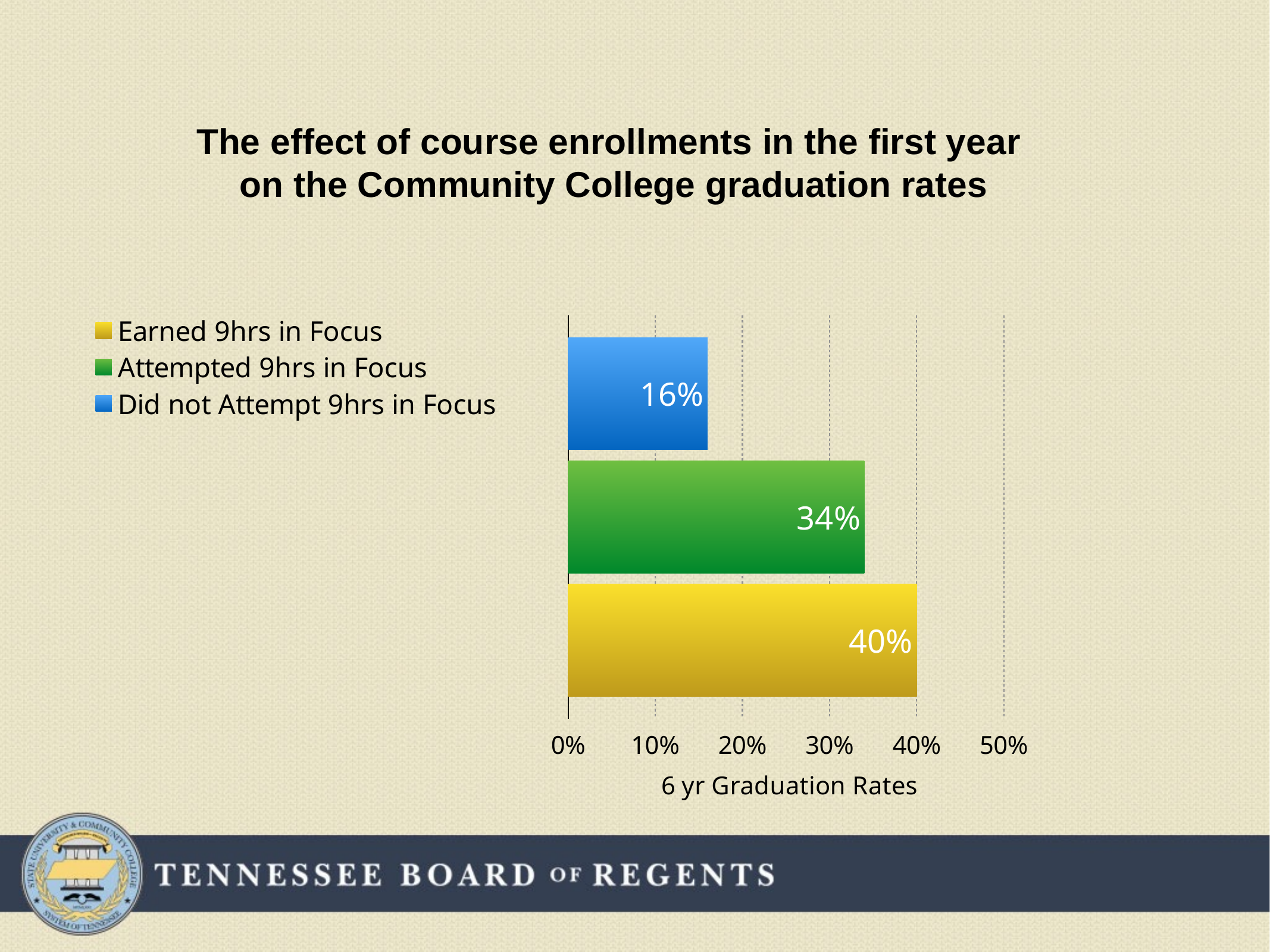
What is the difference in graduation rate between students who earned 9hrs in Focus and those who attempted 9hrs in Focus? 6% Which group has the highest 6 yr graduation rate? Earned 9hrs in Focus How many series does the legend list? 3 What is the label on the horizontal axis of the chart? 6 yr Graduation Rates What is the 6 yr graduation rate for students who attempted 9hrs in Focus? 34% Which has a higher graduation rate: Attempted 9hrs in Focus or Did not Attempt 9hrs in Focus? Attempted 9hrs in Focus What is the 6 yr graduation rate for students who did not attempt 9hrs in Focus? 16% Is the graduation rate for Attempted 9hrs in Focus greater or less than 30%? greater What is the 6 yr graduation rate for students who earned 9hrs in Focus? 40% Which group has the lowest 6 yr graduation rate? Did not Attempt 9hrs in Focus What kind of chart is shown on the slide? Bar chart What is the difference in graduation rate between students who earned 9hrs in Focus and those who did not attempt 9hrs in Focus? 24%